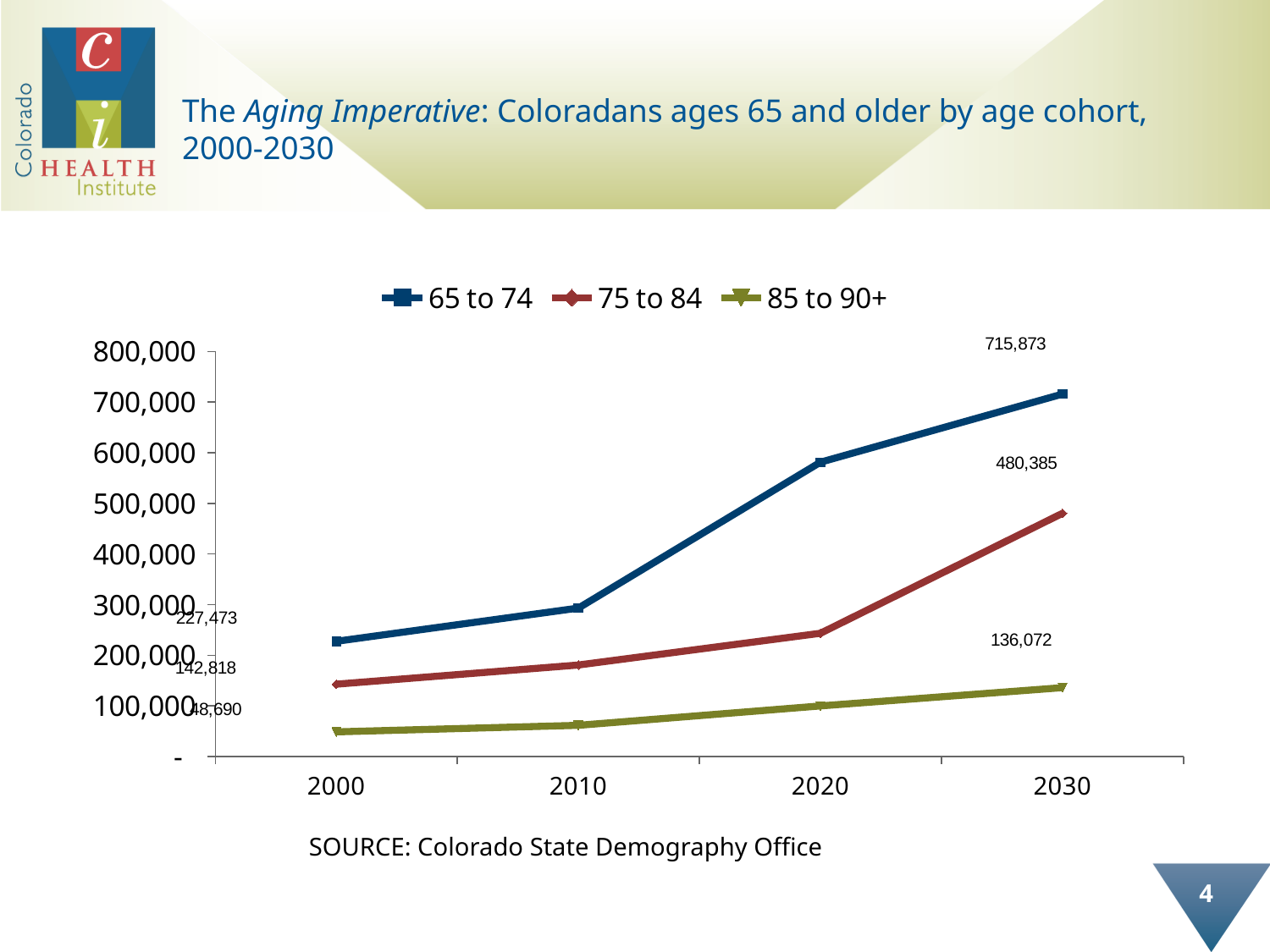
What is the value for the 65 to 74 cohort in 2030? 715,873 What is the value for the 75 to 84 cohort in 2030? 480,385 Which age cohort has the highest value in 2030? 65 to 74 Does the 75 to 84 series rise or fall from 2000 to 2030? rise Is the value for the 65 to 74 cohort in 2020 greater or less than 500,000? greater How many years are shown on the x axis? 4 What is the value for the 65 to 74 cohort in 2000? 227,473 What is the value for the 85 to 90+ cohort in 2030? 136,072 Which age cohort has the lowest value in 2030? 85 to 90+ What is the difference between the 65 to 74 and 75 to 84 values in 2030? 235,488 What type of chart is shown on the slide? line chart How many series does the legend list? 3